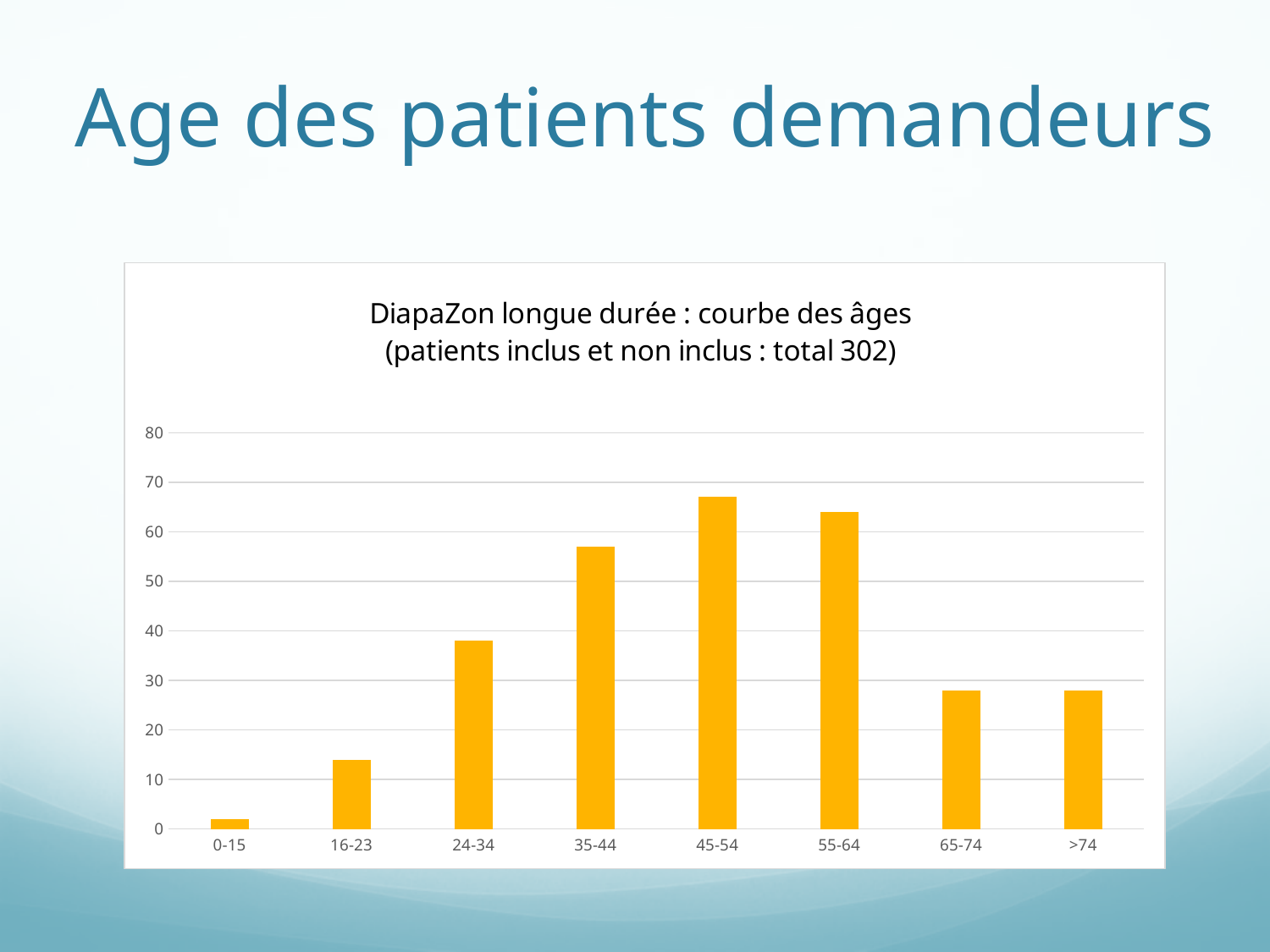
Which age category has the highest value? 45-54 Is the value for 45-54 greater or less than 60? greater Which is larger, the value for 24-34 or the value for 65-74? 24-34 Is the value for 0-15 greater or less than 10? less How many age categories are shown on the x axis? 8 What total number of patients is stated in the chart title? 302 Which age category has the lowest value? 0-15 What kind of chart is shown on the slide? Bar chart Is the value for 16-23 greater or less than 10? greater Do the values rise or fall from the 0-15 category to the 45-54 category? Rise Which is larger, the value for 35-44 or the value for 55-64? 55-64